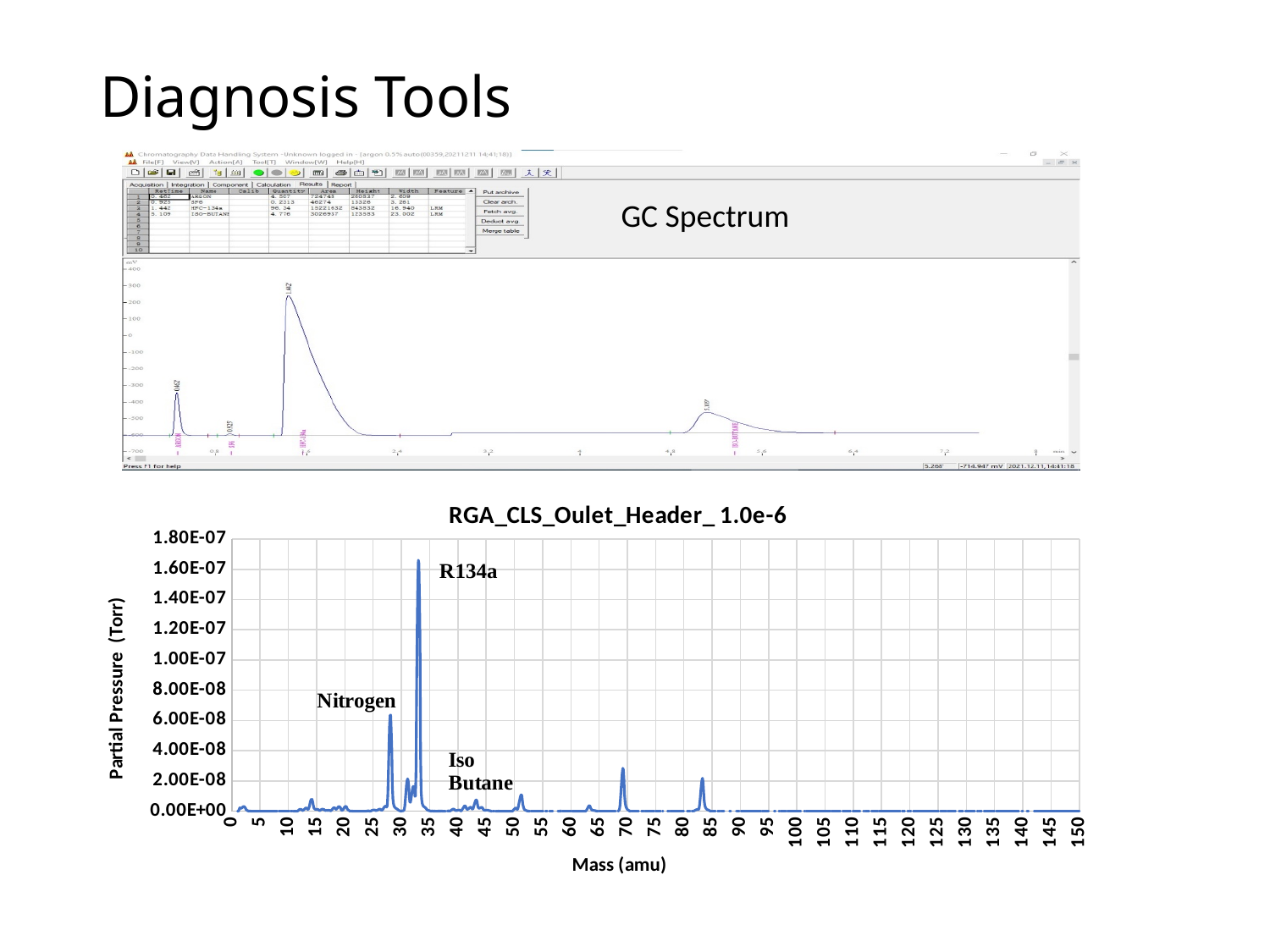
In the bottom chart (RGA_CLS_Oulet_Header_ 1.0e-6), which labeled peak has the highest partial pressure? R134a In the bottom chart (RGA_CLS_Oulet_Header_ 1.0e-6), which labeled peak has the lowest partial pressure? Iso Butane How many peaks are labeled with a substance name in the bottom chart (RGA_CLS_Oulet_Header_ 1.0e-6)? 3 In the bottom chart (RGA_CLS_Oulet_Header_ 1.0e-6), is the Nitrogen peak greater or less than 8.00E-08? less What is the label given to the top chart on the slide? GC Spectrum In the bottom chart (RGA_CLS_Oulet_Header_ 1.0e-6), is the R134a peak greater or less than 1.40E-07? greater In the bottom chart (RGA_CLS_Oulet_Header_ 1.0e-6), which peak is higher, R134a or Nitrogen? R134a What kind of chart is the bottom chart (RGA_CLS_Oulet_Header_ 1.0e-6)? line chart In the bottom chart (RGA_CLS_Oulet_Header_ 1.0e-6), is the Iso Butane peak greater or less than 2.00E-08? less What is the title of the bottom chart? RGA_CLS_Oulet_Header_ 1.0e-6 In the bottom chart (RGA_CLS_Oulet_Header_ 1.0e-6), what is the y-axis label? Partial Pressure (Torr)